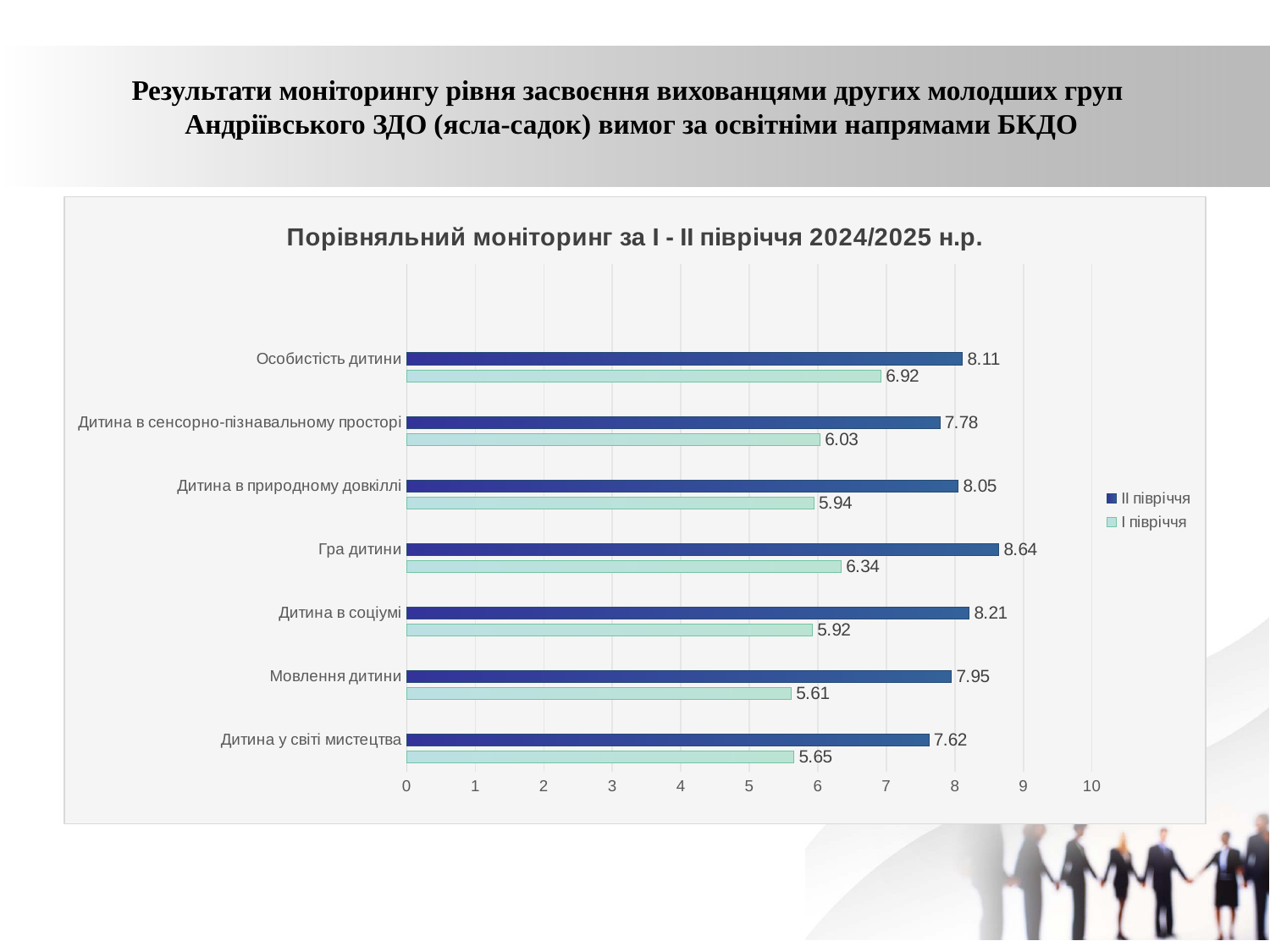
What type of chart is shown on the slide? bar chart Which is larger: the "І півріччя" value for "Особистість дитини" or the "І півріччя" value for "Дитина в соціумі"? Особистість дитини Is the "ІІ півріччя" value for "Дитина в соціумі" greater or less than 8? greater What is the value for "Мовлення дитини" in the "І півріччя" series? 5.61 What is the value for "Дитина в сенсорно-пізнавальному просторі" in the "І півріччя" series? 6.03 How many series does the legend list? 2 Which category has the highest value in the "І півріччя" series? Особистість дитини What is the value for "Гра дитини" in the "ІІ півріччя" series? 8.64 How many categories are shown on the chart? 7 What is the difference between the "ІІ півріччя" and "І півріччя" values for "Гра дитини"? 2.30 Which category has the lowest value in the "ІІ півріччя" series? Дитина у світі мистецтва Which category has the highest value in the "ІІ півріччя" series? Гра дитини